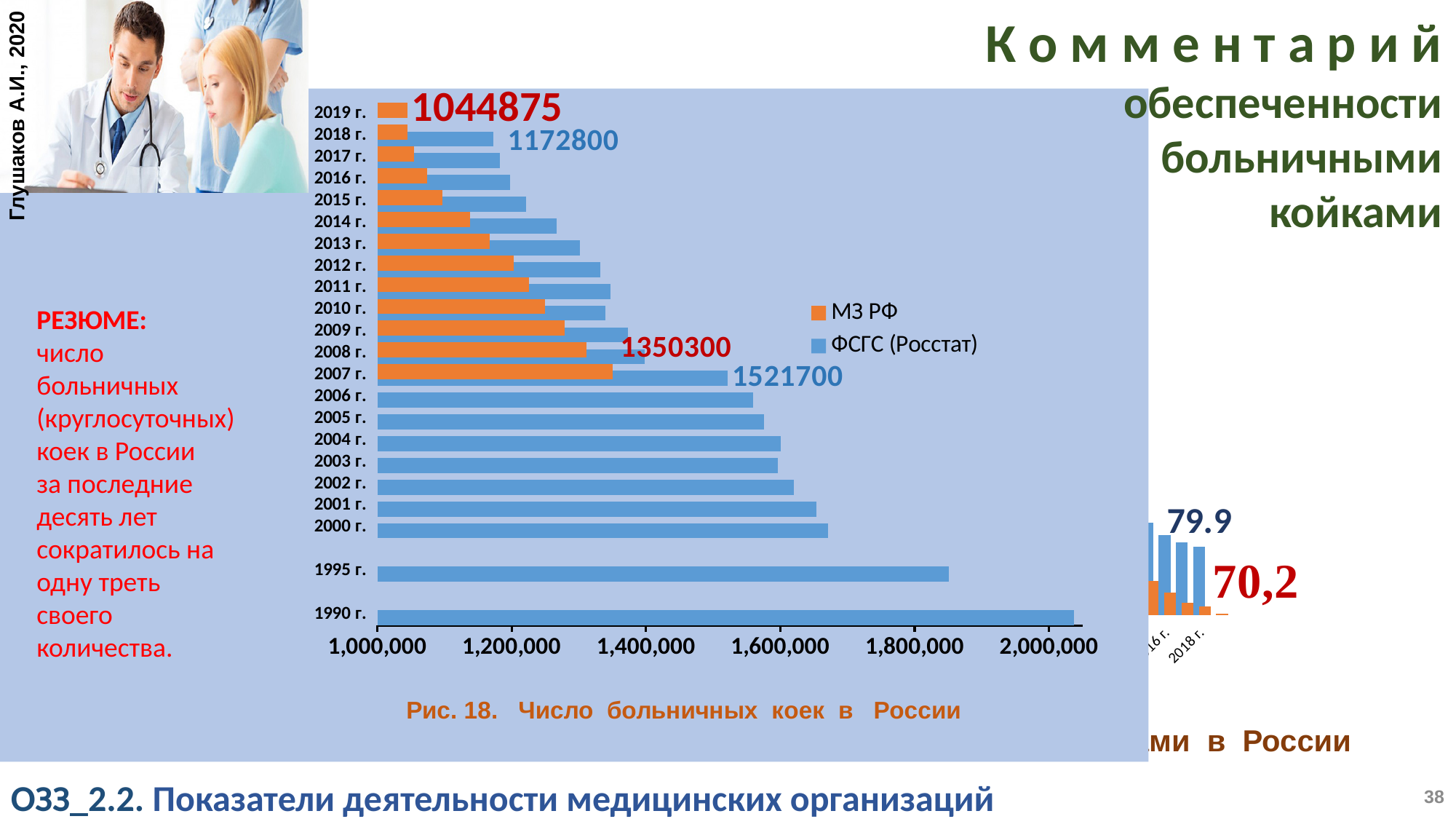
In the chart Число больничных коек в России, is the ФСГС (Росстат) value for 1990 г. greater or less than 2,000,000? greater In the chart Число больничных коек в России, how many year categories are shown on the vertical axis? 22 How many series does the legend of the chart Число больничных коек в России list? 2 What kind of chart is Рис. 18 (Число больничных коек в России)? bar chart In the chart Число больничных коек в России, what is the ФСГС (Росстат) value for 2007 г.? 1521700 In the chart Число больничных коек в России, which year has the highest ФСГС (Росстат) value? 1990 г. In the chart Число больничных коек в России, what is the ФСГС (Росстат) value for 2018 г.? 1172800 In the chart Число больничных коек в России, what is the difference between the ФСГС (Росстат) value for 2007 г. and the ФСГС (Росстат) value for 2018 г.? 348900 In the chart Число больничных коек в России, do the ФСГС (Росстат) values rise or fall from 1990 г. to 2019 г.? fall In the chart Число больничных коек в России, what is the МЗ РФ value for 2019 г.? 1044875